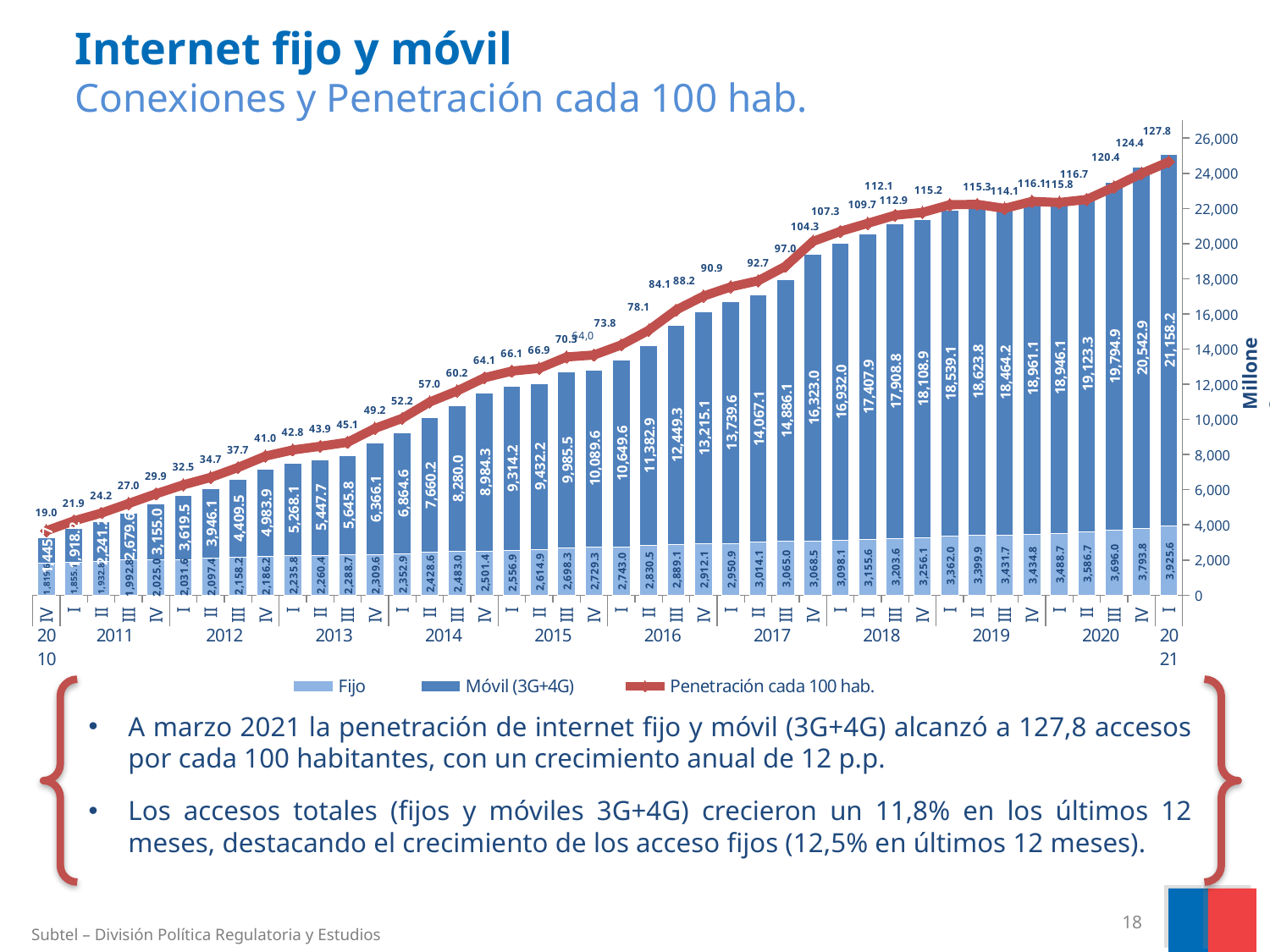
How many series does the legend list? 3 Which is larger, Móvil (3G+4G) in II 2019 or in III 2019? II 2019 What is the difference in Penetración cada 100 hab. between I 2021 and IV 2020? 3.4 Does Penetración cada 100 hab. rise or fall overall from IV 2010 to I 2021? Rise What is the value of Móvil (3G+4G) for IV 2017? 16,323.0 What type of chart is shown on the slide? Stacked bar chart with a line In which period is Penetración cada 100 hab. highest? I 2021 What is the Penetración cada 100 hab. value for IV 2010? 19.0 What is the value of Móvil (3G+4G) for I 2021? 21,158.2 What is the total of the stacked bar (Fijo plus Móvil) for I 2021? 25,083.8 What is the Penetración cada 100 hab. value for I 2021? 127.8 What is the value of Fijo for I 2021? 3,925.6